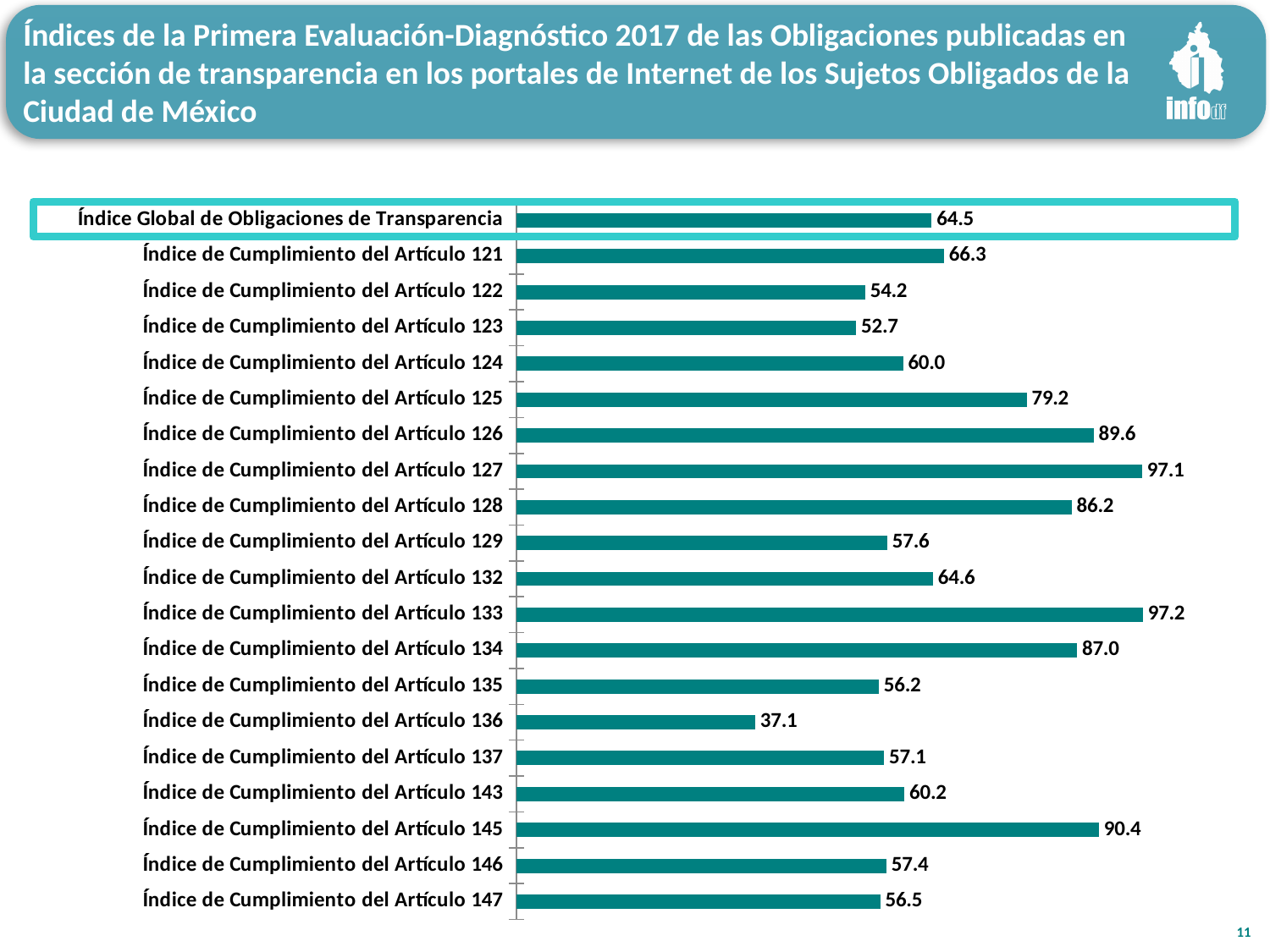
What kind of chart is shown on the slide? Bar chart Which category is highlighted with a box around it? Índice Global de Obligaciones de Transparencia What is the value for Índice Global de Obligaciones de Transparencia? 64.5 Which is larger, the value for Artículo 133 or the value for Artículo 134? Artículo 133 What is the value for Índice de Cumplimiento del Artículo 127? 97.1 What is the difference between the values for Artículo 121 and the Índice Global de Obligaciones de Transparencia? 1.8 Which is larger, the value for Artículo 124 or the value for Artículo 136? Artículo 124 How many categories are shown in the chart? 20 What is the difference between the values for Artículo 126 and Artículo 125? 10.4 What is the value for Índice de Cumplimiento del Artículo 145? 90.4 What is the value for Índice de Cumplimiento del Artículo 136? 37.1 Which category has the lowest value? Índice de Cumplimiento del Artículo 136